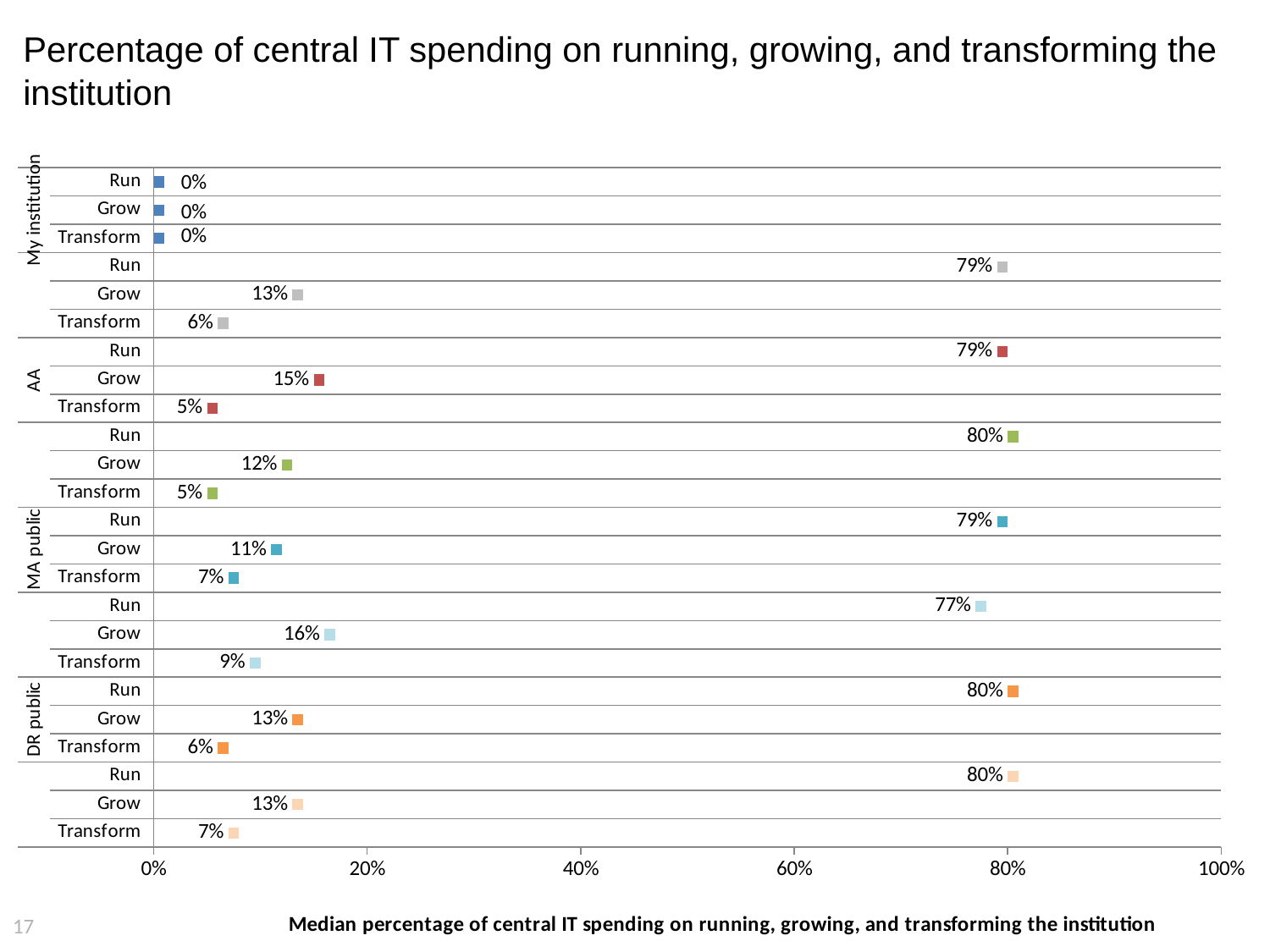
What is the difference between Grow and Transform in the DR public group? 7% Which is larger: Grow for AA or Grow for MA public? AA What is the value for Run under My institution? 0% What is the maximum value shown on the x axis? 100% What is the value for Run in the DR public group? 80% What is the difference between Run and Grow in the AA group? 64% What kind of chart is shown on the slide? bar chart Is the value for Run in the DR public group greater or less than 60%? greater What is the caption printed below the chart's x axis? Median percentage of central IT spending on running, growing, and transforming the institution What is the value for Grow in the AA group? 15% What is the value for Run in the AA group? 79% What is the value for Transform in the MA public group? 7%